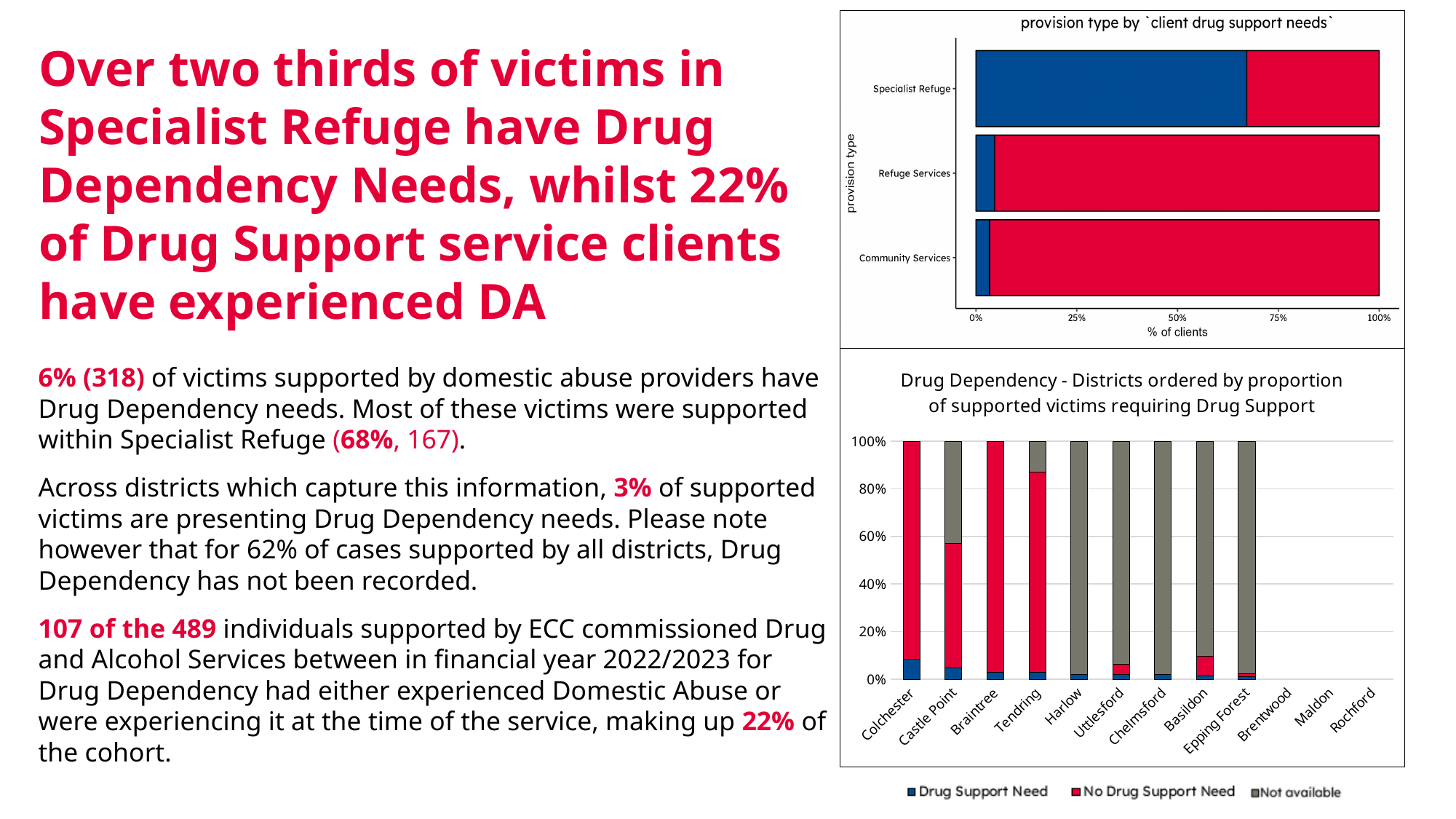
In the bottom chart 'Drug Dependency - Districts ordered by proportion of supported victims requiring Drug Support', is the Not available (grey) share for Castle Point greater or less than 20%? greater In the bottom chart 'Drug Dependency - Districts ordered by proportion of supported victims requiring Drug Support', is the No Drug Support Need (red) share for Tendring greater or less than 60%? greater In the bottom chart 'Drug Dependency - Districts ordered by proportion of supported victims requiring Drug Support', which district has the largest Drug Support Need (blue) share? Colchester In the top chart 'provision type by `client drug support needs`', is the blue (drug support need) share for Specialist Refuge greater or less than 50%? greater How many series does the legend of the bottom chart 'Drug Dependency - Districts ordered by proportion of supported victims requiring Drug Support' list? 3 What kind of chart is the top chart titled 'provision type by `client drug support needs`'? bar chart In the top chart 'provision type by `client drug support needs`', which provision type has the largest share of clients with a drug support need (blue)? Specialist Refuge In the top chart 'provision type by `client drug support needs`', which has the larger blue (drug support need) share: Specialist Refuge or Community Services? Specialist Refuge How many districts are listed on the x axis of the bottom chart 'Drug Dependency - Districts ordered by proportion of supported victims requiring Drug Support'? 12 In the bottom chart 'Drug Dependency - Districts ordered by proportion of supported victims requiring Drug Support', which colour represents 'Not available' in the legend? grey How many provision types are shown in the top chart 'provision type by `client drug support needs`'? 3